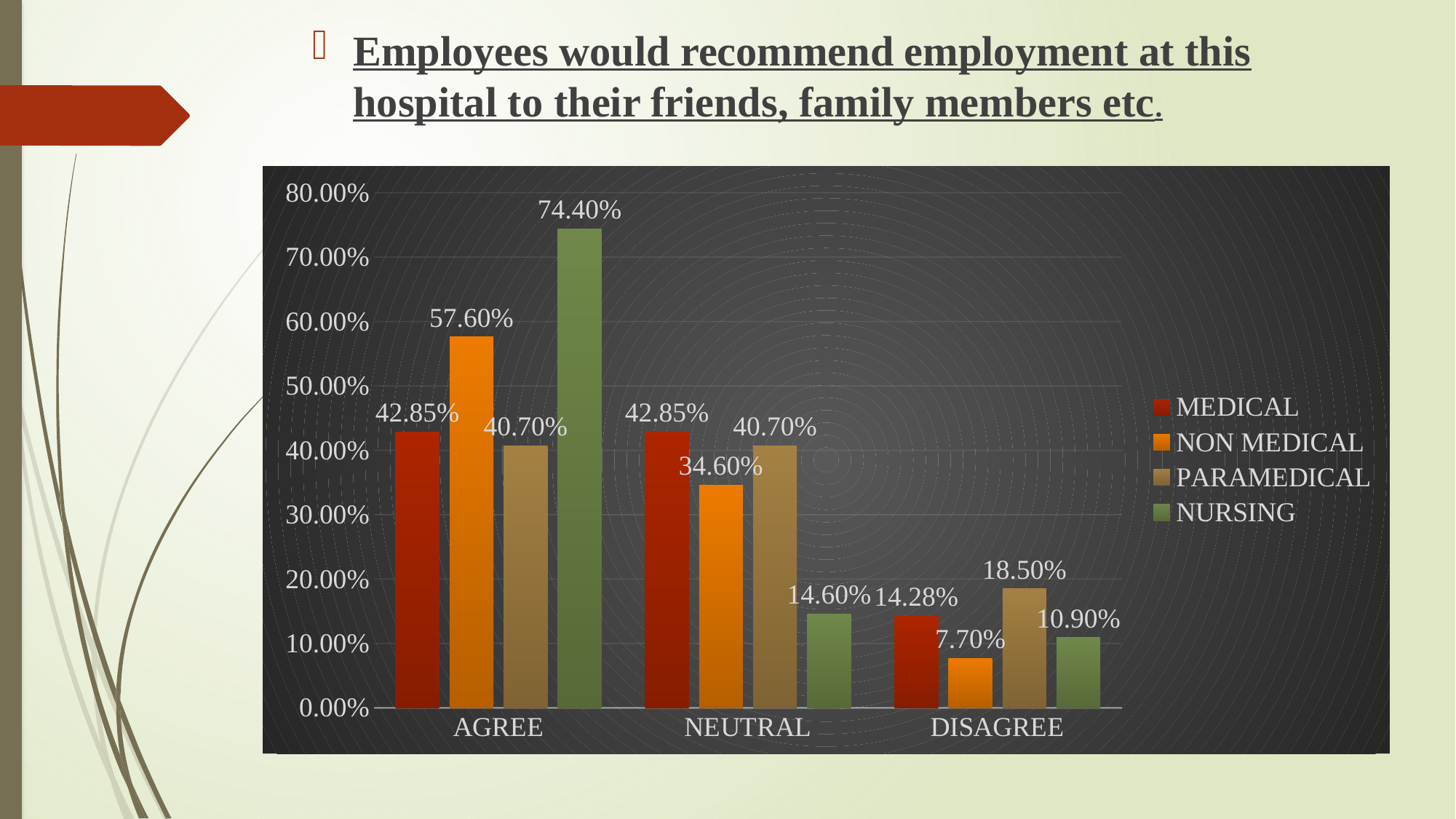
Which is larger: the NON MEDICAL value for AGREE or the NON MEDICAL value for NEUTRAL? AGREE What kind of chart is shown on the slide? Bar chart Which series has the lowest value in the DISAGREE category? NON MEDICAL What is the value for NON MEDICAL in the NEUTRAL category? 34.60% What is the difference between the NURSING and MEDICAL values in the AGREE category? 31.55% What percentage of NURSING employees chose AGREE? 74.40% Which series has the highest value in the AGREE category? NURSING Do the NURSING values rise or fall from AGREE to DISAGREE? Fall How many series does the legend list? 4 How many categories are shown on the x axis? 3 What is the value for PARAMEDICAL in the DISAGREE category? 18.50% Which colour represents the NON MEDICAL series in the legend? Orange